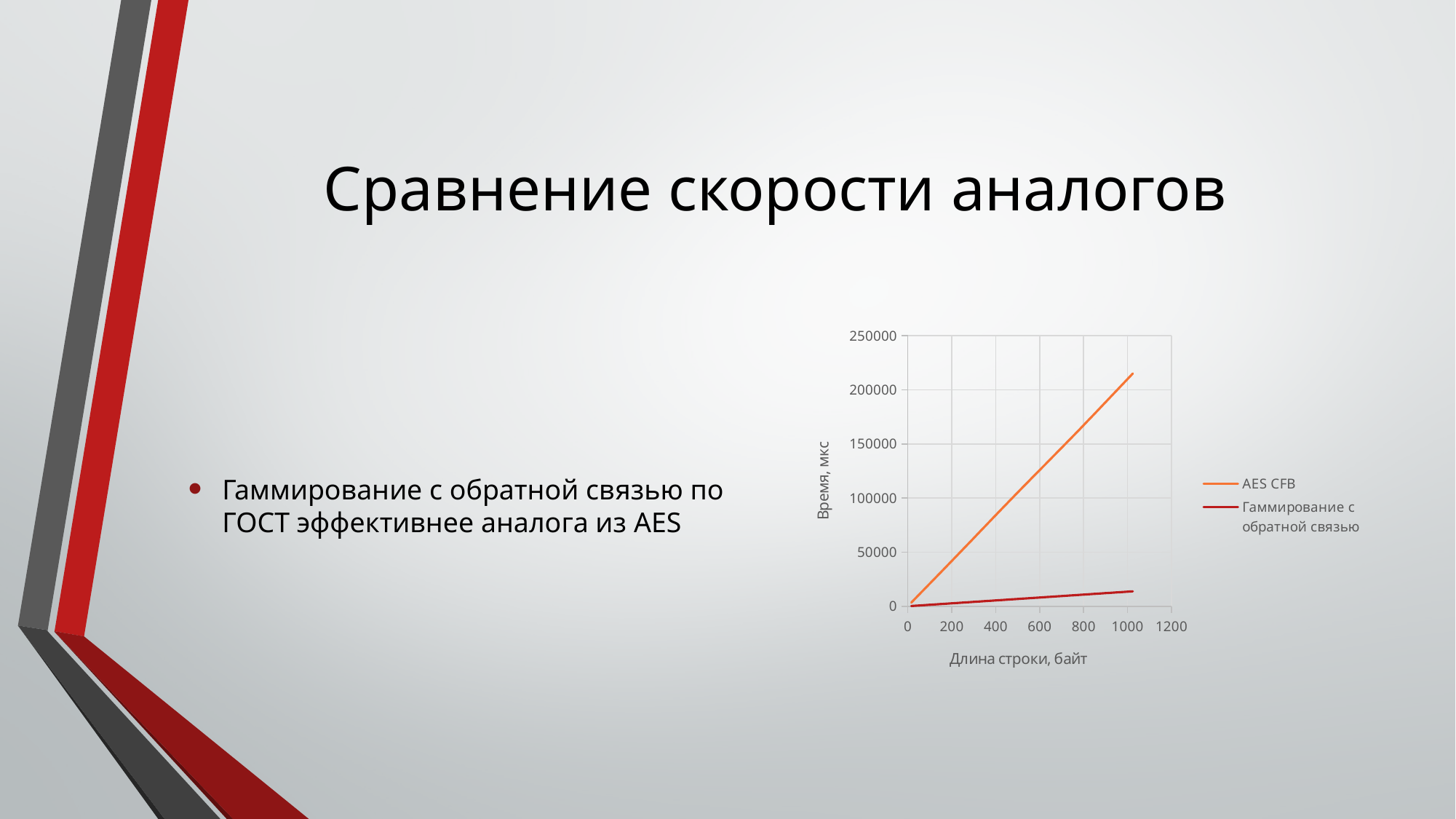
Is the value of AES CFB at a string length of about 1000 bytes greater or less than 150000? greater What is the highest value shown on the horizontal axis of the chart? 1200 Does the AES CFB line rise or fall as string length increases? rises How many series does the chart legend list? 2 Which series is drawn in orange in the chart? AES CFB Is the value of Гаммирование с обратной связью at a string length of about 1000 bytes greater or less than 50000? less What is the highest value shown on the vertical axis of the chart? 250000 Does the Гаммирование с обратной связью line rise or fall as string length increases? rises What is the title of the vertical axis of the chart? Время, мкс What kind of chart is shown on the slide? line chart Which series has the higher value at a string length of about 1000 bytes, AES CFB or Гаммирование с обратной связью? AES CFB What is the title of the horizontal axis of the chart? Длина строки, байт